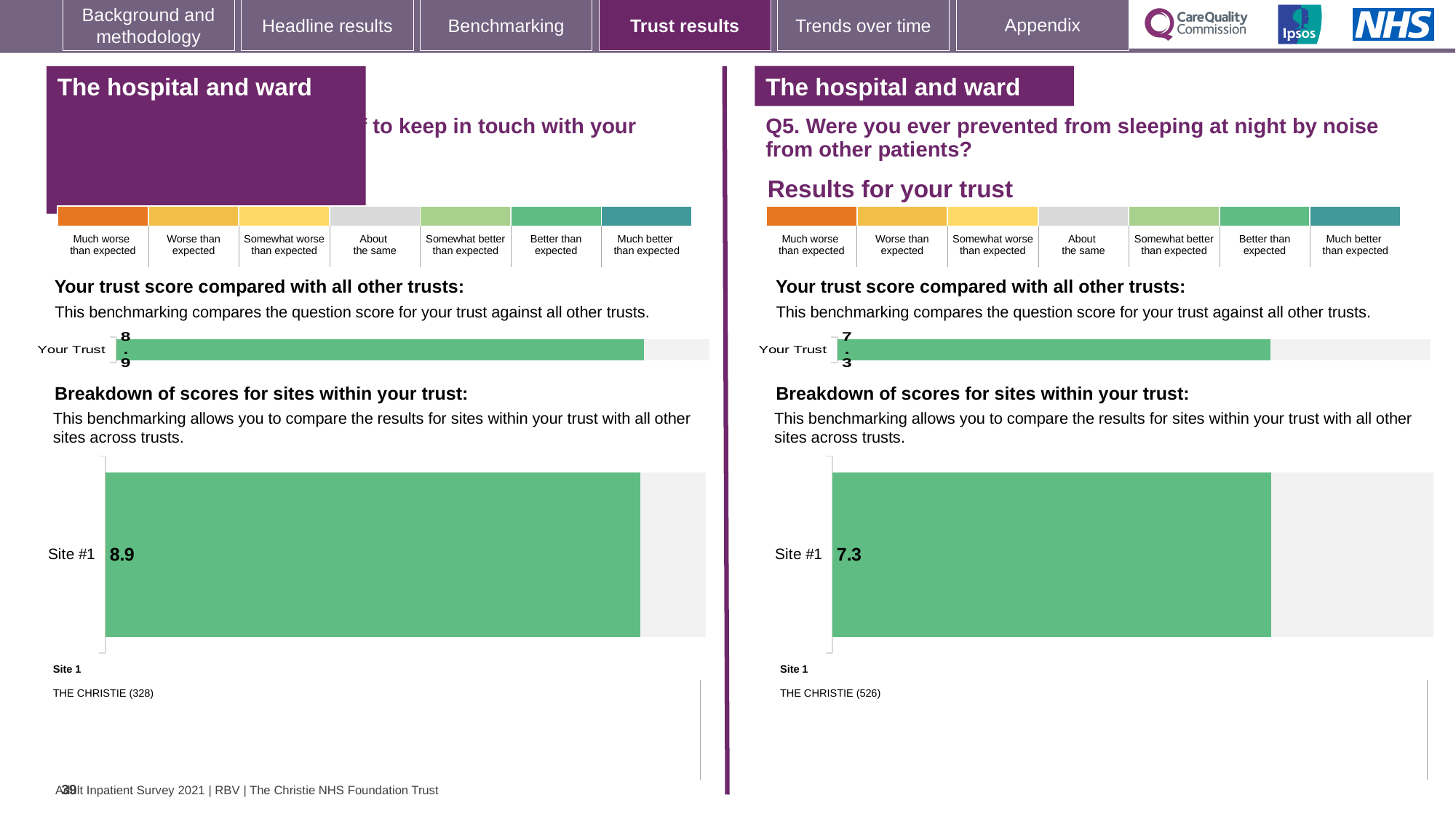
On the right-hand Q5 breakdown of scores for sites within your trust, what is the score for Site #1? 7.3 On the left-hand chart, what is the score shown for Your Trust? 8.9 How many sites are shown in the left-hand breakdown of scores for sites within your trust? 1 What type of chart is used to show the Site #1 score on the right-hand Q5 chart? Bar chart How many sites are shown in the right-hand Q5 breakdown of scores for sites within your trust? 1 Which Site #1 score is larger: the one on the left-hand chart or the one on the right-hand Q5 chart? The left-hand chart (8.9) On the left-hand breakdown of scores for sites within your trust, what is the score for Site #1? 8.9 On the right-hand chart for Q5 (prevented from sleeping at night by noise from other patients), what is the score shown for Your Trust? 7.3 What colour is the Site #1 bar on the right-hand Q5 chart? Green What is the difference between the Site #1 score on the left-hand chart and the Site #1 score on the right-hand Q5 chart? 1.6 Which site name is listed under Site 1 on the right-hand Q5 chart? THE CHRISTIE (526)